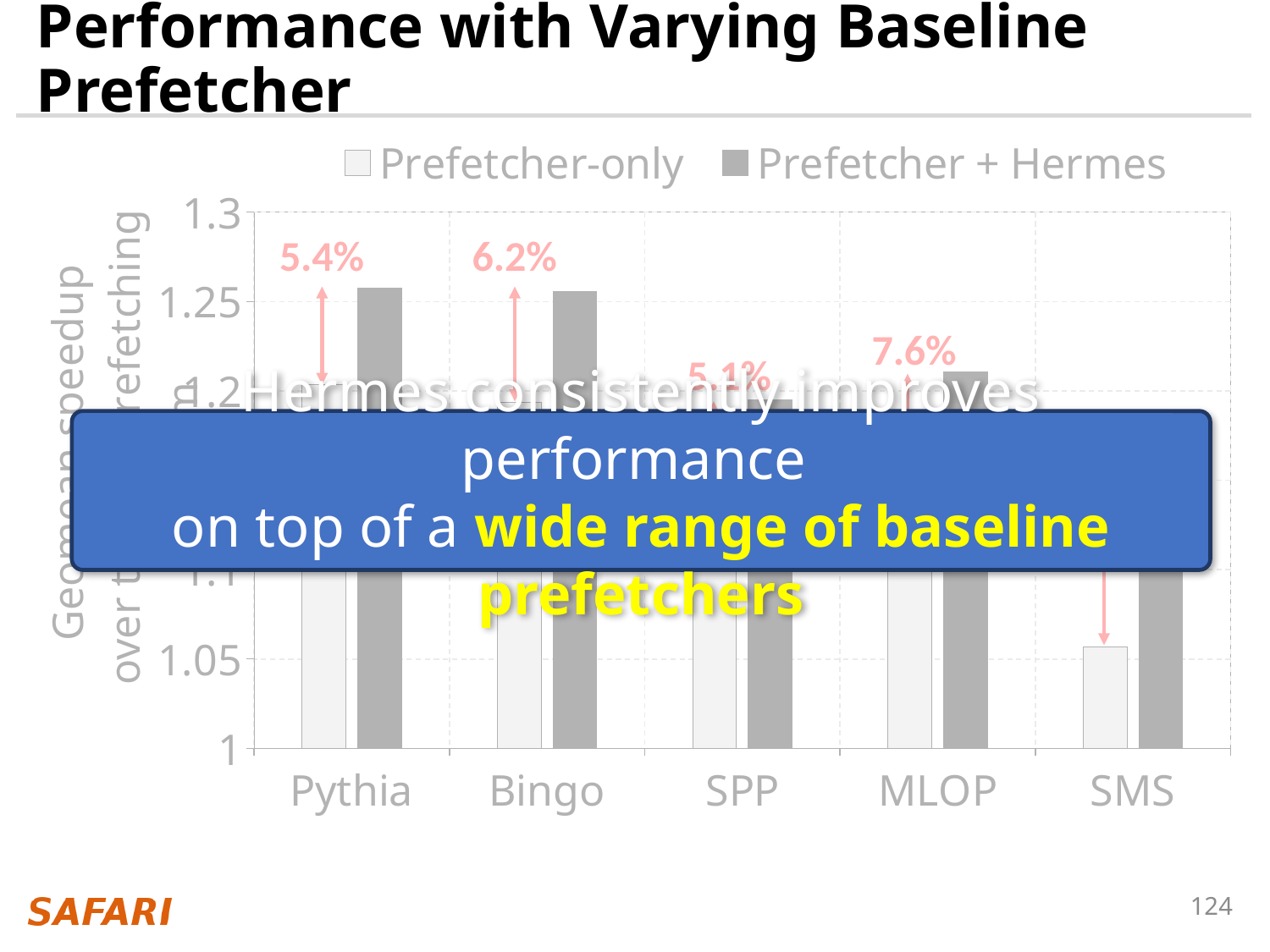
What kind of chart is shown on the slide? bar chart What improvement percentage is labelled above the MLOP bars? 7.6% What is the difference between the improvement percentages labelled for MLOP and Pythia? 2.2 percentage points Which prefetcher has the lowest Prefetcher + Hermes bar? SMS What improvement percentage is labelled above the SPP bars? 5.1% What are the two series named in the legend? Prefetcher-only and Prefetcher + Hermes What improvement percentage is labelled above the Pythia bars? 5.4% Is the Prefetcher + Hermes value for Pythia greater or less than 1.25? greater How many series does the legend list? 2 How many baseline prefetchers (categories) are shown on the x axis? 5 Among the improvement percentages that are readable on the slide, which prefetcher has the highest? MLOP What improvement percentage is labelled above the Bingo bars? 6.2%